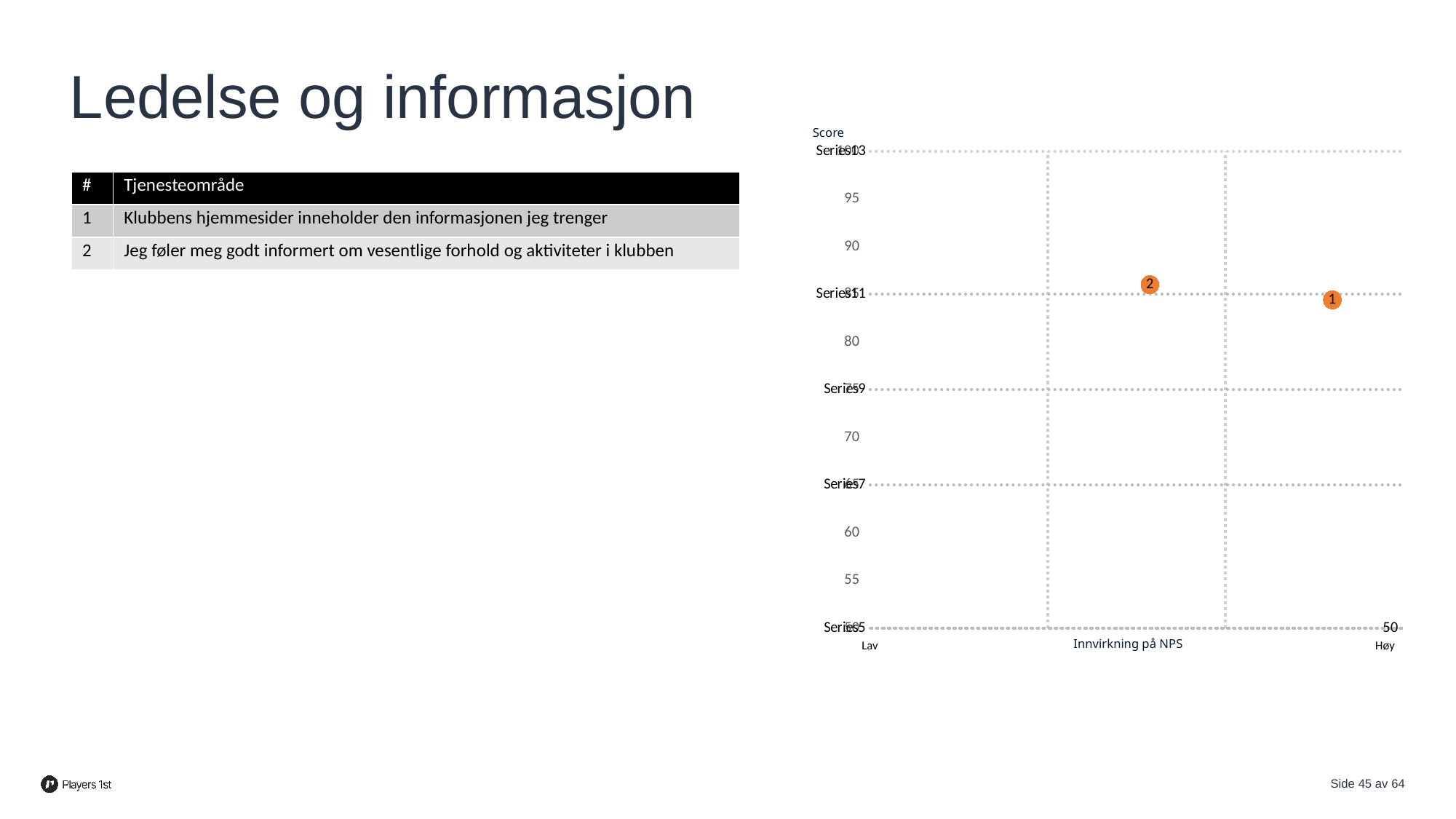
Is the score for point 1 greater or less than 90? less Is the score for point 2 greater or less than 90? less Is the score for point 1 greater or less than 80? greater What is the title of the vertical axis of the chart? Score Which point lies further to the right on the 'Innvirkning på NPS' axis, point 1 or point 2? point 1 What is the highest value shown on the vertical axis? 100 What is the title of the horizontal axis of the chart? Innvirkning på NPS How many data points are plotted on the chart? 2 What kind of chart is shown on the slide? scatter chart